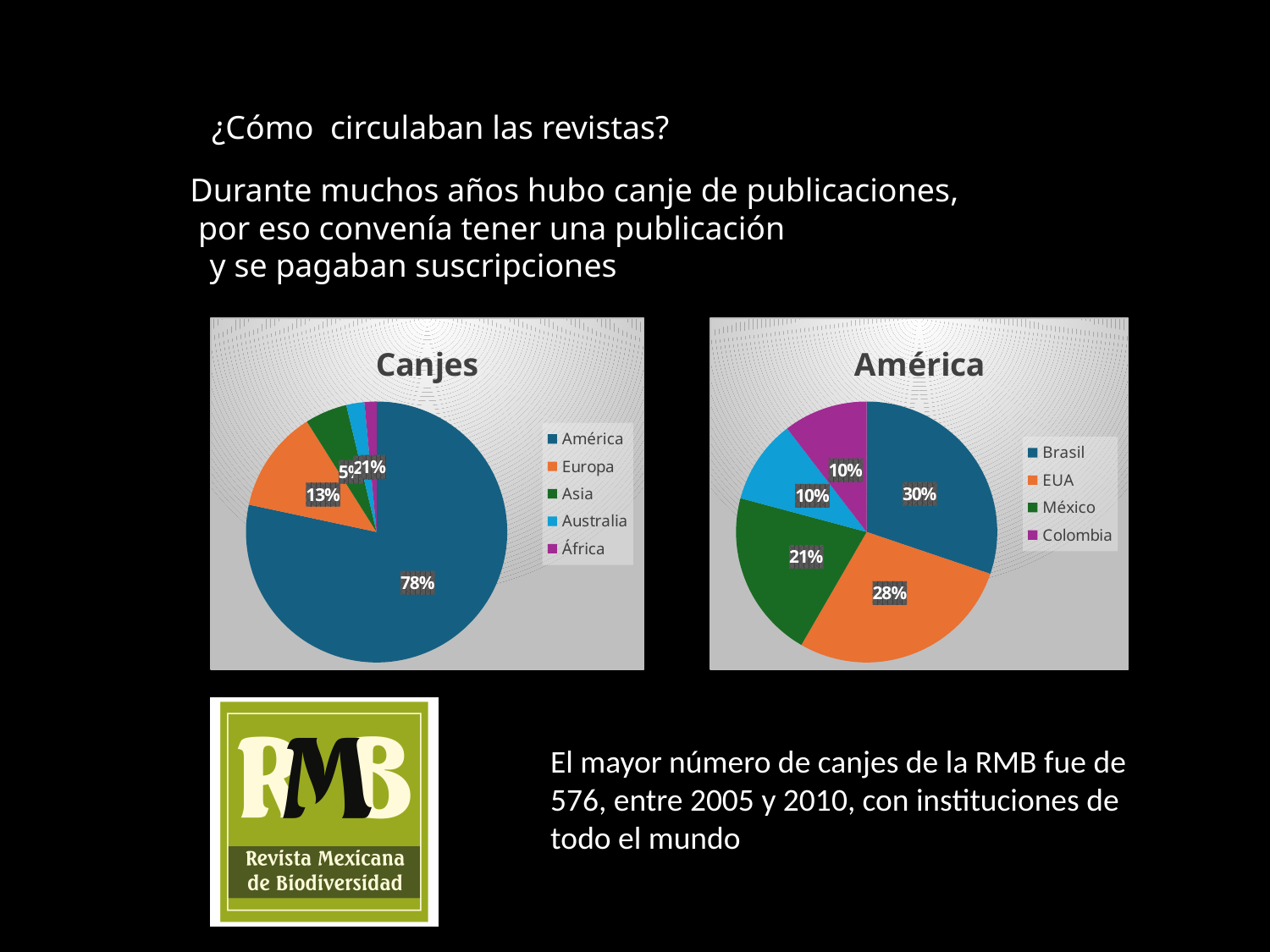
In the "Canjes" pie chart, what percentage is shown for América? 78% In the "Canjes" pie chart, how many percentage points larger is América's share than Europa's? 65% What kind of chart is the "Canjes" chart? Pie chart In the "América" pie chart, what percentage is shown for Colombia? 10% In the "América" pie chart, what percentage is shown for EUA? 28% In the "Canjes" pie chart, which region has the largest share? América In the "América" pie chart, what percentage is shown for Brasil? 30% In the "América" pie chart, what percentage is shown for México? 21% How many entries does the legend of the "América" chart list? 4 How many entries does the legend of the "Canjes" chart list? 5 In the "América" pie chart, which of EUA or México has the larger share? EUA In the "Canjes" pie chart, what percentage is shown for Europa? 13%